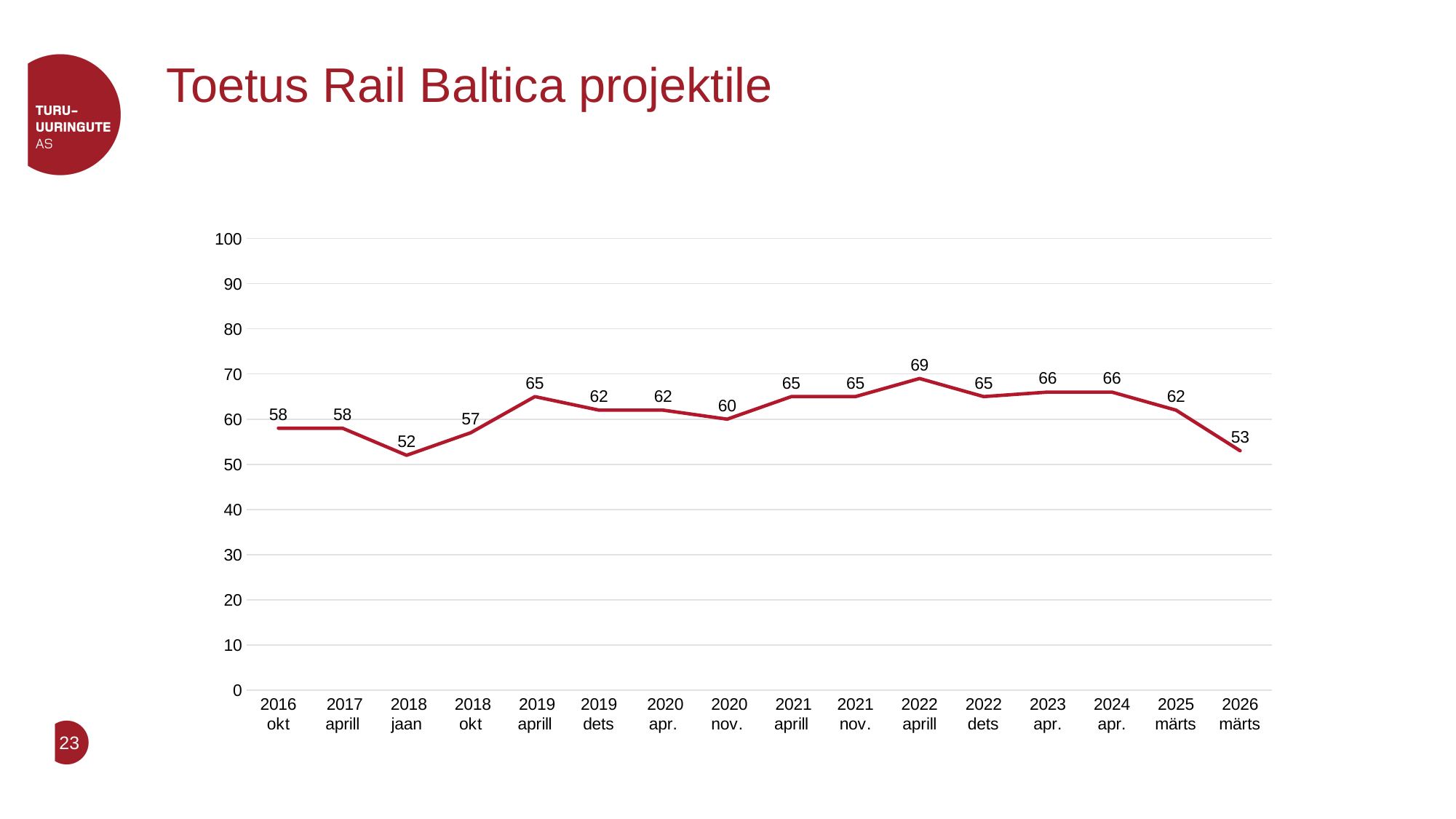
What kind of chart is shown on the slide? line chart What is the value for 2026 märts? 53 What is the difference between the values for 2019 aprill and 2018 okt? 8 What is the title of the slide? Toetus Rail Baltica projektile What is the value for 2020 nov.? 60 Which time point has the highest value? 2022 aprill What is the value for 2018 jaan? 52 How many time points are plotted on the chart? 16 What is the value for 2022 aprill? 69 What is the difference between the values for 2022 aprill and 2026 märts? 16 Which time point has the lowest value? 2018 jaan Which is larger, the value for 2023 apr. or the value for 2025 märts? 2023 apr.